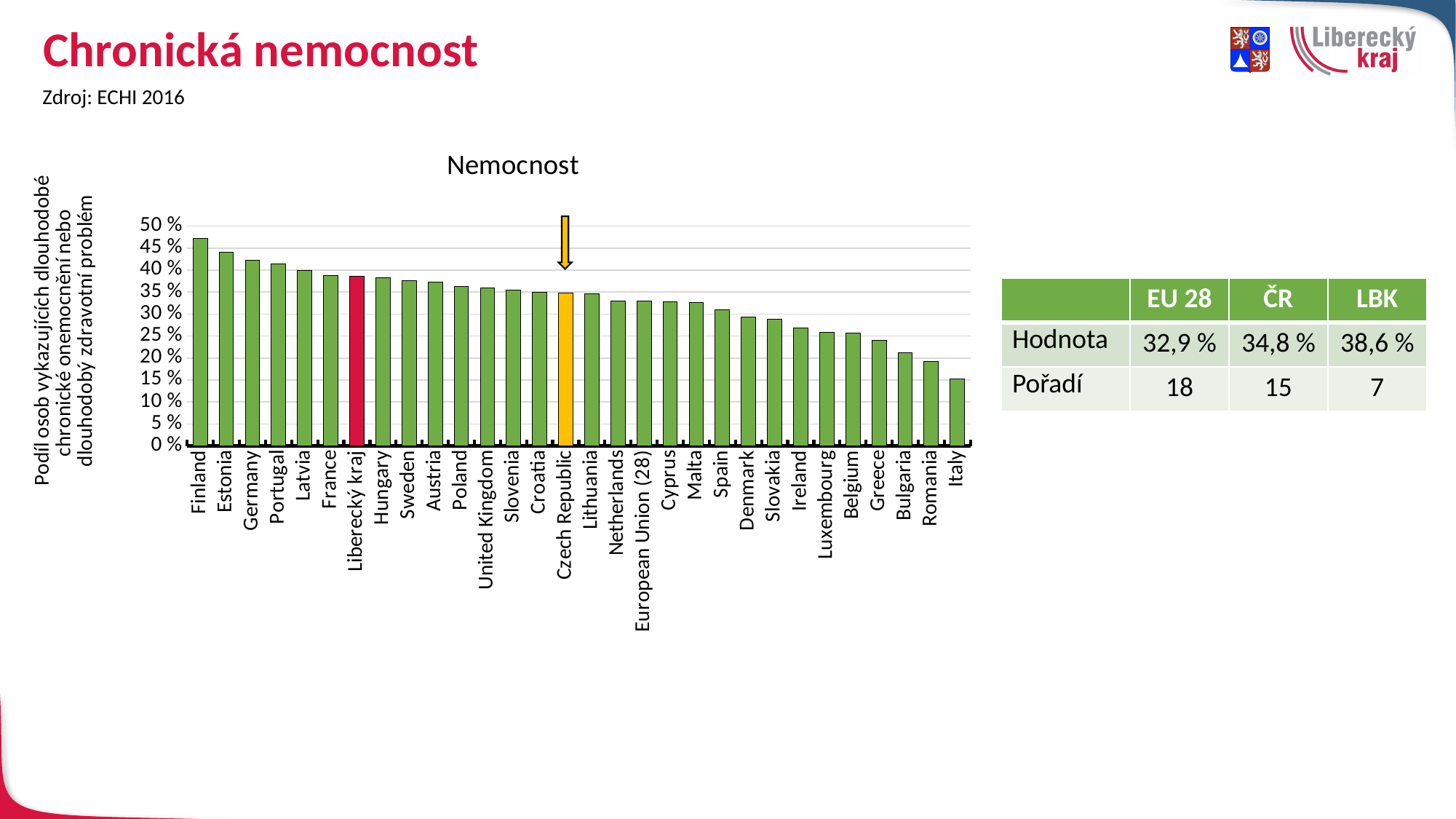
What kind of chart is shown on the slide? bar chart What is the value for Liberecký kraj (LBK)? 38,6 % What is the difference between the values for Liberecký kraj and the Czech Republic? 3,8 % What is the value for the Czech Republic (ČR)? 34,8 % Which category has the highest value in the chart? Finland Do the values rise or fall from left to right along the x axis? fall How many categories (bars) does the chart show? 30 What is the title of the chart? Nemocnost Which category has the lowest value in the chart? Italy Is the value for Italy greater or less than 20 %? less Is the value for Finland greater or less than 45 %? greater What is the value for EU 28? 32,9 %